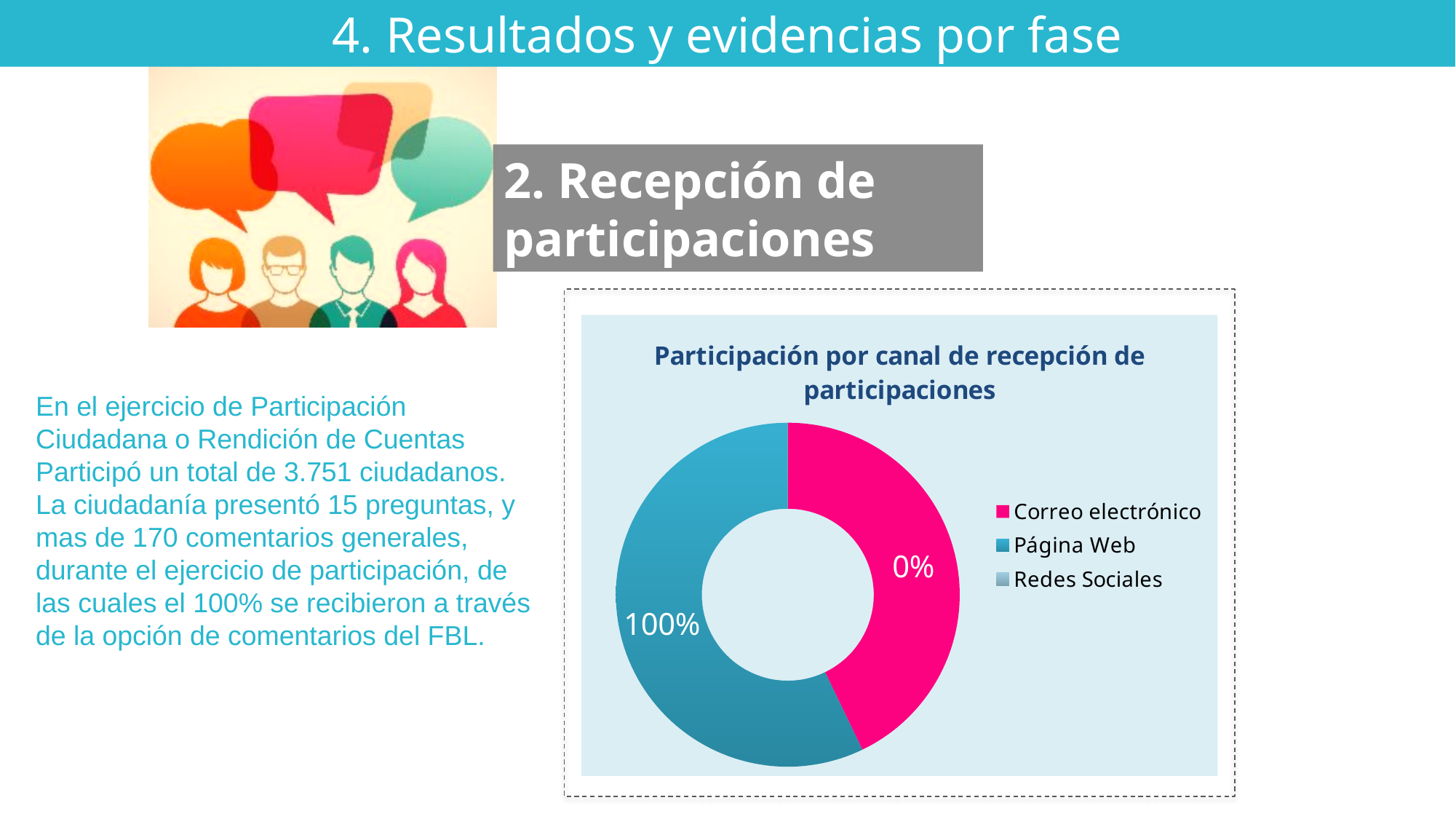
According to the data labels, which channel has the highest share of participations? Página Web What percentage is labelled on the Página Web slice? 100% According to the data labels, which is larger: the share for Página Web or the share for Correo electrónico? Página Web What percentage is labelled on the Correo electrónico slice? 0% What is the title of the chart? Participación por canal de recepción de participaciones What share of the pie does Página Web account for according to its label? 100% What is the difference between the labelled shares of Página Web and Correo electrónico? 100% What kind of chart is shown on the slide? Doughnut chart How many entries does the chart legend list? 3 Which legend entry is shown in pink? Correo electrónico